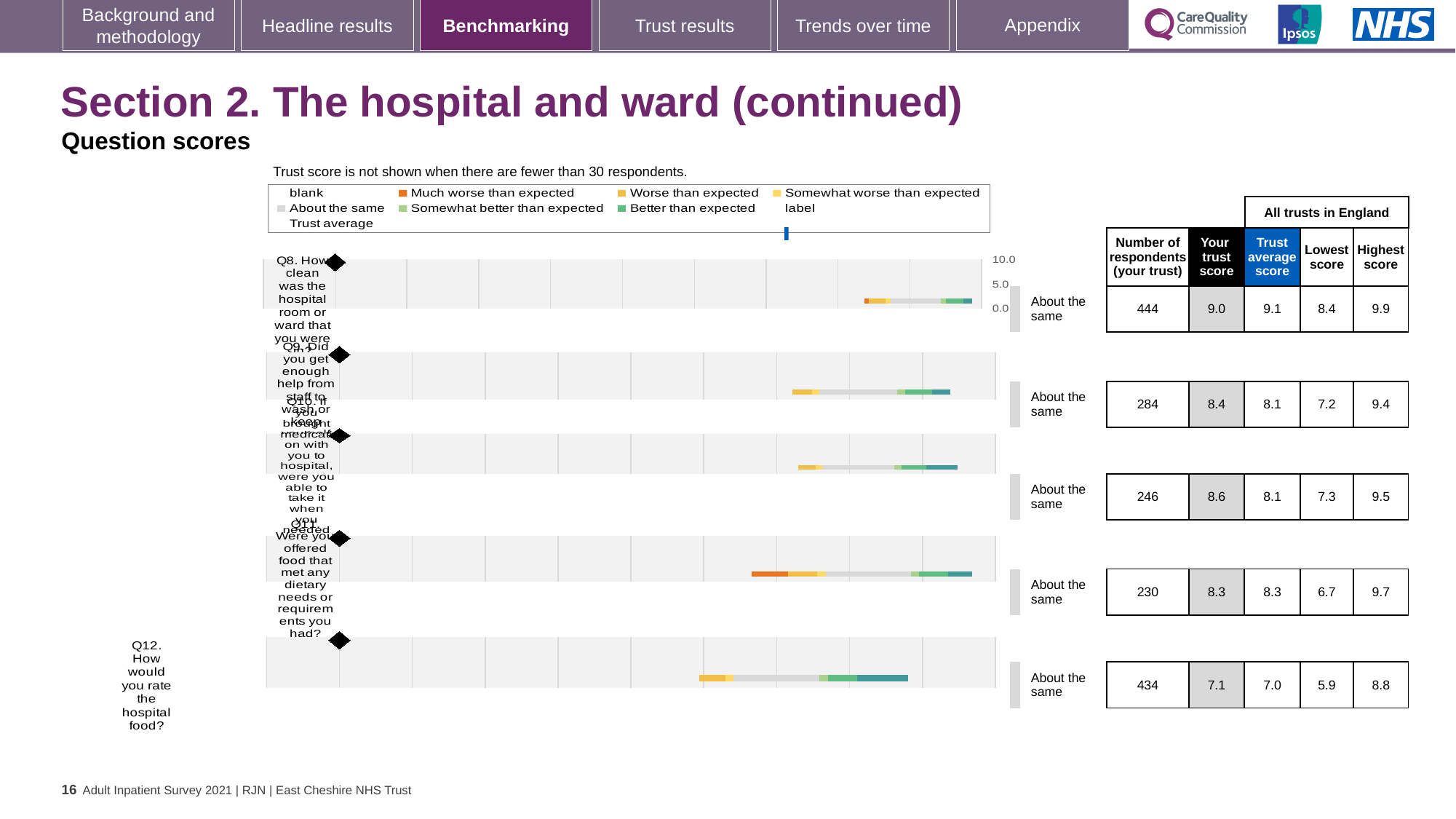
What is the lowest score across all trusts in England for Q11 (dietary needs)? 6.7 Which question has the lowest 'Your trust score'? Q12 Which question has the highest 'Your trust score'? Q8 For Q8, what is the difference between the highest score and the lowest score across all trusts in England? 1.5 What is the trust score for Q12 (How would you rate the hospital food)? 7.1 For Q9, which is larger: the trust score or the trust average score? Your trust score (8.4) What benchmark category is shown for Q10? About the same What kind of chart is used to show the question scores on this slide? bar chart What is the number of respondents for Q8 (How clean was the hospital room or ward)? 444 How many questions (Q8 to Q12) are plotted on the chart? 5 What is the trust average score for Q10 (medication brought with you to hospital)? 8.1 For Q12, how much higher is the trust score than the trust average score? 0.1